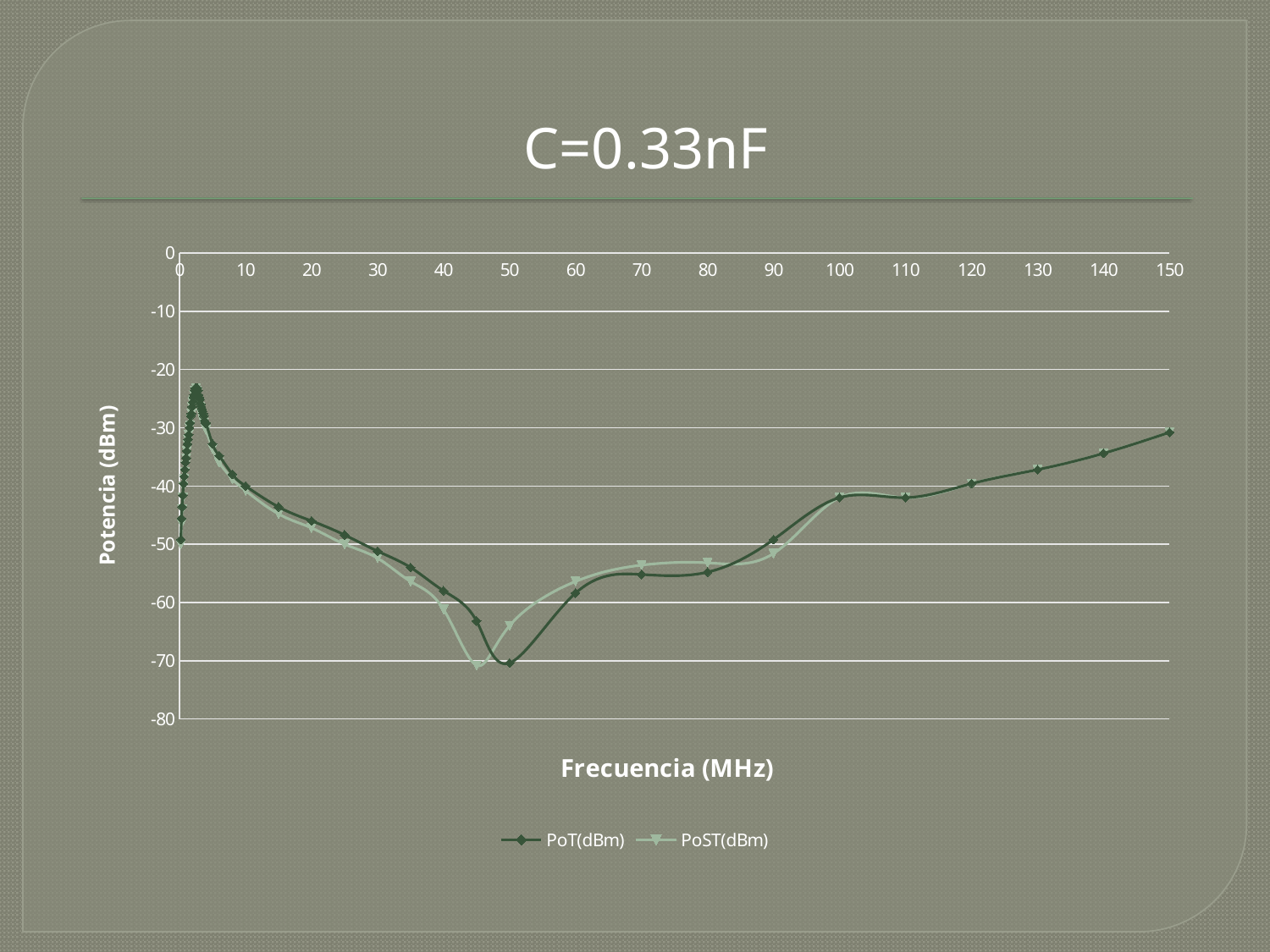
Is the value of PoT(dBm) at 50 MHz greater or less than -60? less Between 50 MHz and 150 MHz, does PoT(dBm) rise or fall? rise At 45 MHz, which series has the larger value, PoT(dBm) or PoST(dBm)? PoT(dBm) Is the value of PoT(dBm) at 150 MHz greater or less than -40? greater Is the value of PoT(dBm) at 20 MHz greater or less than -40? less How many series does the legend list? 2 What is the label of the x axis? Frecuencia (MHz) What is the title of the chart? C=0.33nF At which frequency does PoT(dBm) reach its lowest value? 50 MHz What kind of chart is shown on the slide? line chart At 50 MHz, which series has the larger value, PoT(dBm) or PoST(dBm)? PoST(dBm)